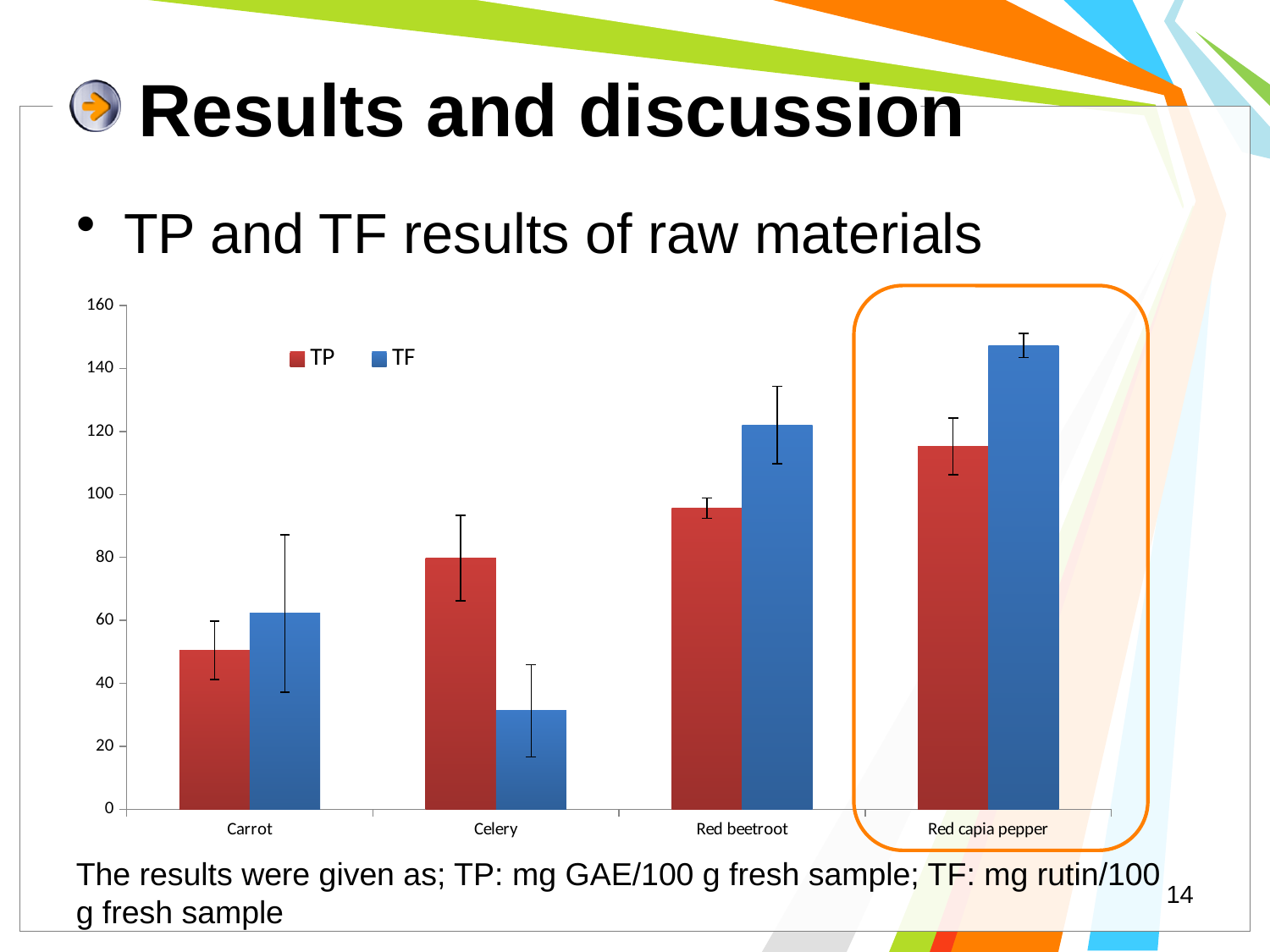
For Celery, which is larger, TP or TF? TP Which raw material has the highest TF value? Red capia pepper Which raw material has the lowest TF value? Celery How many raw materials (categories) are shown on the x axis? 4 What kind of chart is shown on the slide? bar chart For Red beetroot, which is larger, TP or TF? TF Is the TP value for Red beetroot greater or less than 100? less Which colour represents the TP series in the legend? red How many series does the legend list? 2 Is the TF value for Red capia pepper greater or less than 140? greater Is the TF value for Celery greater or less than 40? less Which raw material has the lowest TP value? Carrot